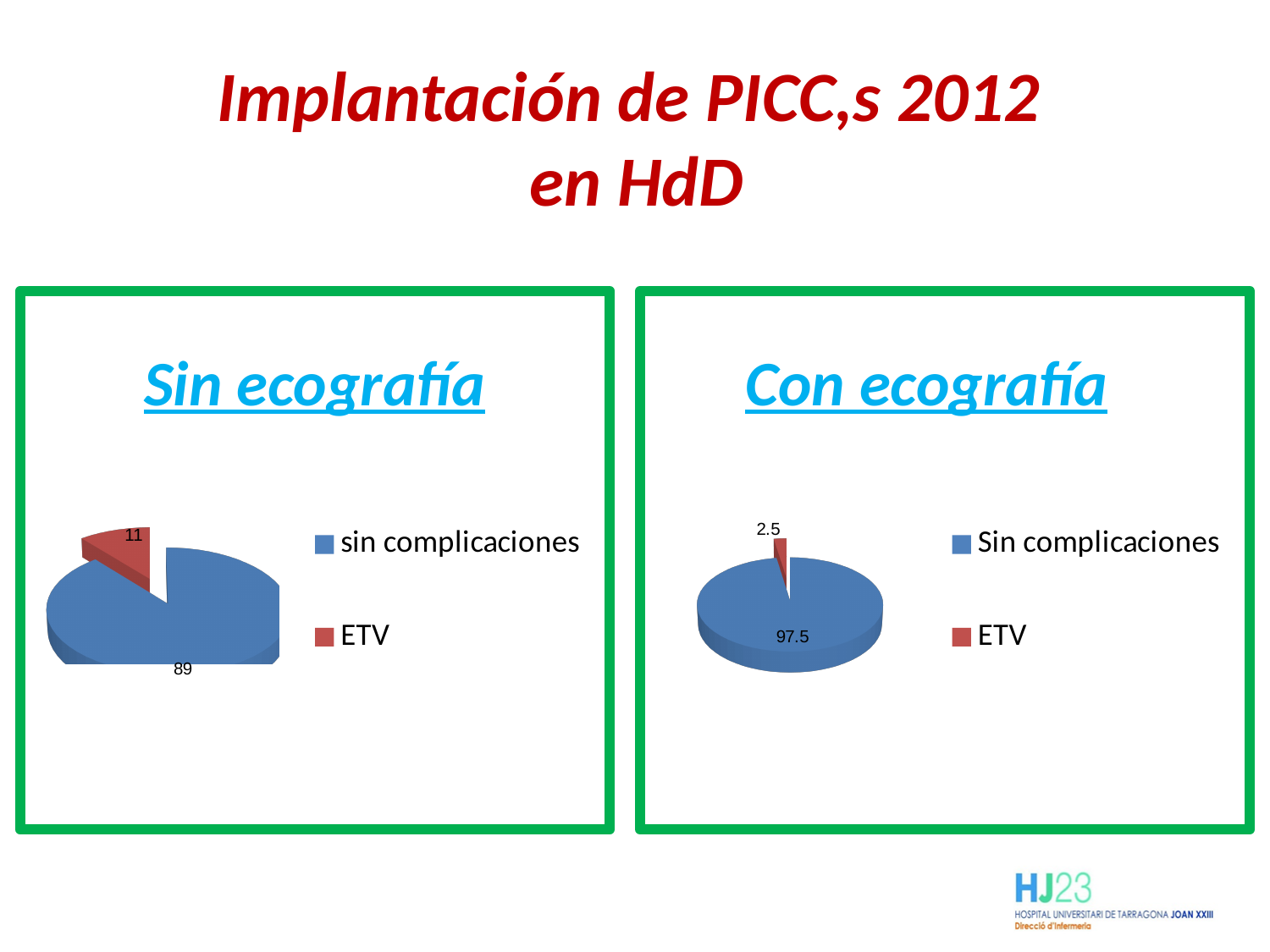
Which chart has the larger ETV value, "Sin ecografía" or "Con ecografía"? Sin ecografía In the "Con ecografía" chart, what is the difference between the Sin complicaciones value and the ETV value? 95 In the "Con ecografía" chart, which slice is the smallest? ETV In the "Sin ecografía" chart, what is the difference between the sin complicaciones value and the ETV value? 78 In the "Sin ecografía" chart, what is the value for ETV? 11 In the "Con ecografía" chart, what is the value for Sin complicaciones? 97.5 In the "Con ecografía" chart, what colour is the ETV slice? Red In the "Sin ecografía" chart, what is the value for sin complicaciones? 89 What type of chart is the "Con ecografía" chart? Pie chart How many slices does the "Sin ecografía" pie chart have? 2 In the "Con ecografía" chart, what is the value for ETV? 2.5 In the "Sin ecografía" chart, which slice is the largest? sin complicaciones